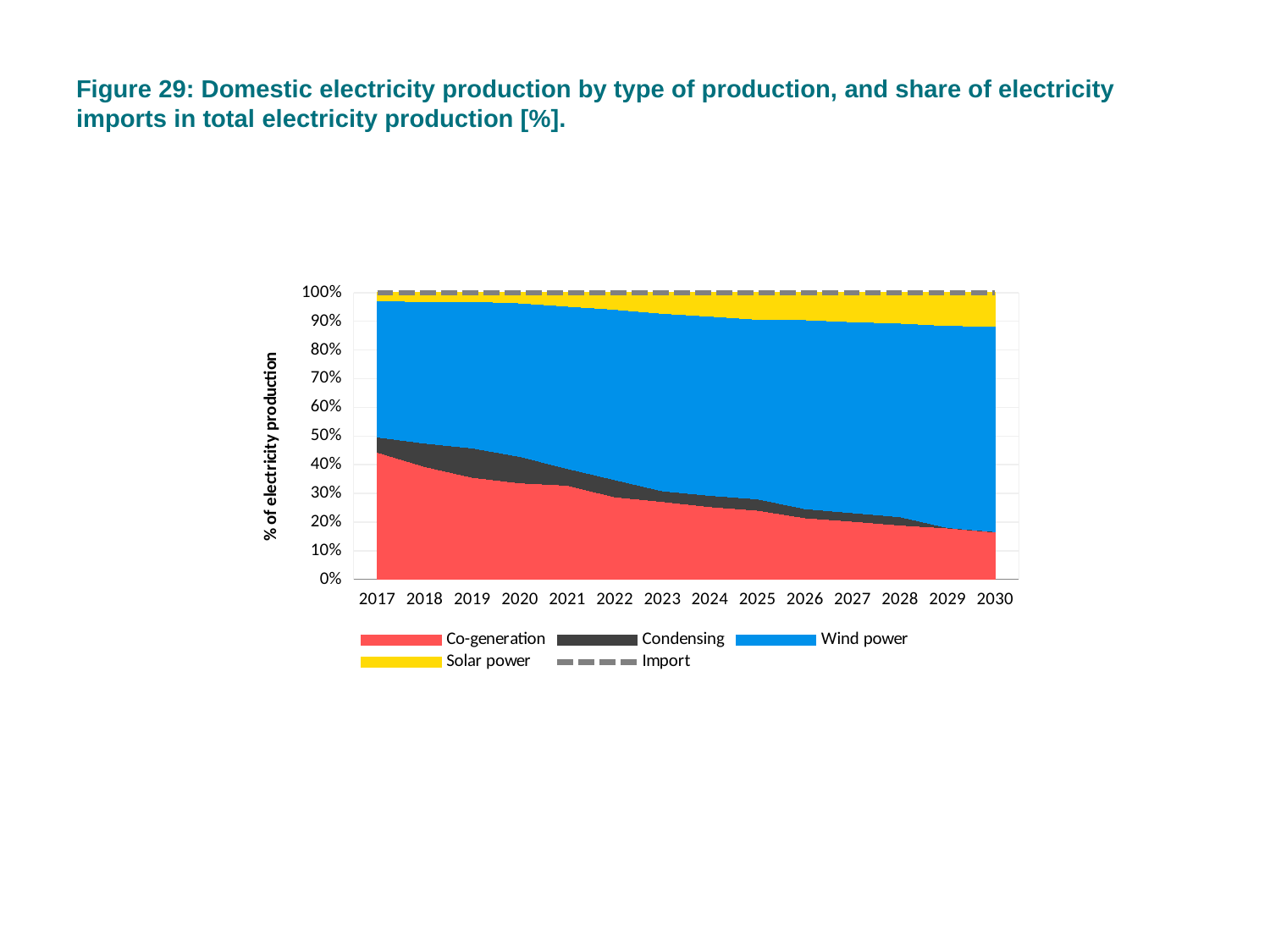
Is the share of Co-generation in 2017 greater or less than 40%? greater How many years are shown along the x axis of the chart? 14 Is the share of Co-generation in 2030 greater or less than 20%? less What is the label of the y axis? % of electricity production Does the share of Co-generation rise or fall from 2017 to 2030? Fall Does the share of Wind power rise or fall from 2017 to 2030? Rise Which year is the first shown on the x axis? 2017 What kind of chart is shown on the slide? Stacked area chart Which series is shown in blue? Wind power How many series does the chart's legend list? 5